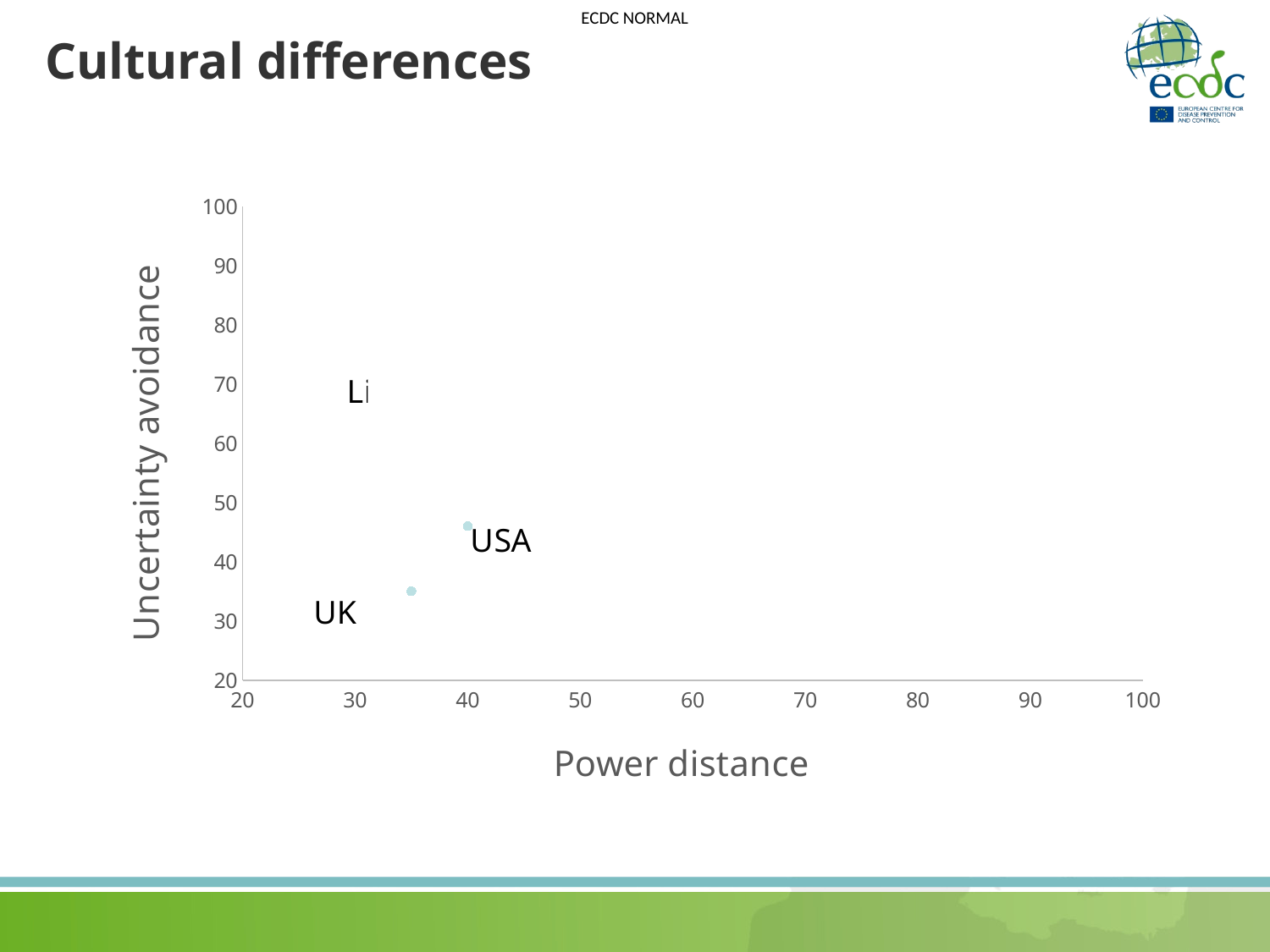
Which has the higher power distance, the UK or the USA? USA What kind of chart is shown on the slide? scatter chart Is the power distance value for the USA greater or less than 50? less What is the label of the horizontal axis of the chart? Power distance What is the highest value shown on the horizontal axis of the chart? 100 Is the power distance value for the UK greater or less than 30? greater Which has the higher uncertainty avoidance, the UK or the USA? USA Is the uncertainty avoidance value for the UK greater or less than 40? less What is the label of the vertical axis of the chart? Uncertainty avoidance How many data points are plotted on the chart? 2